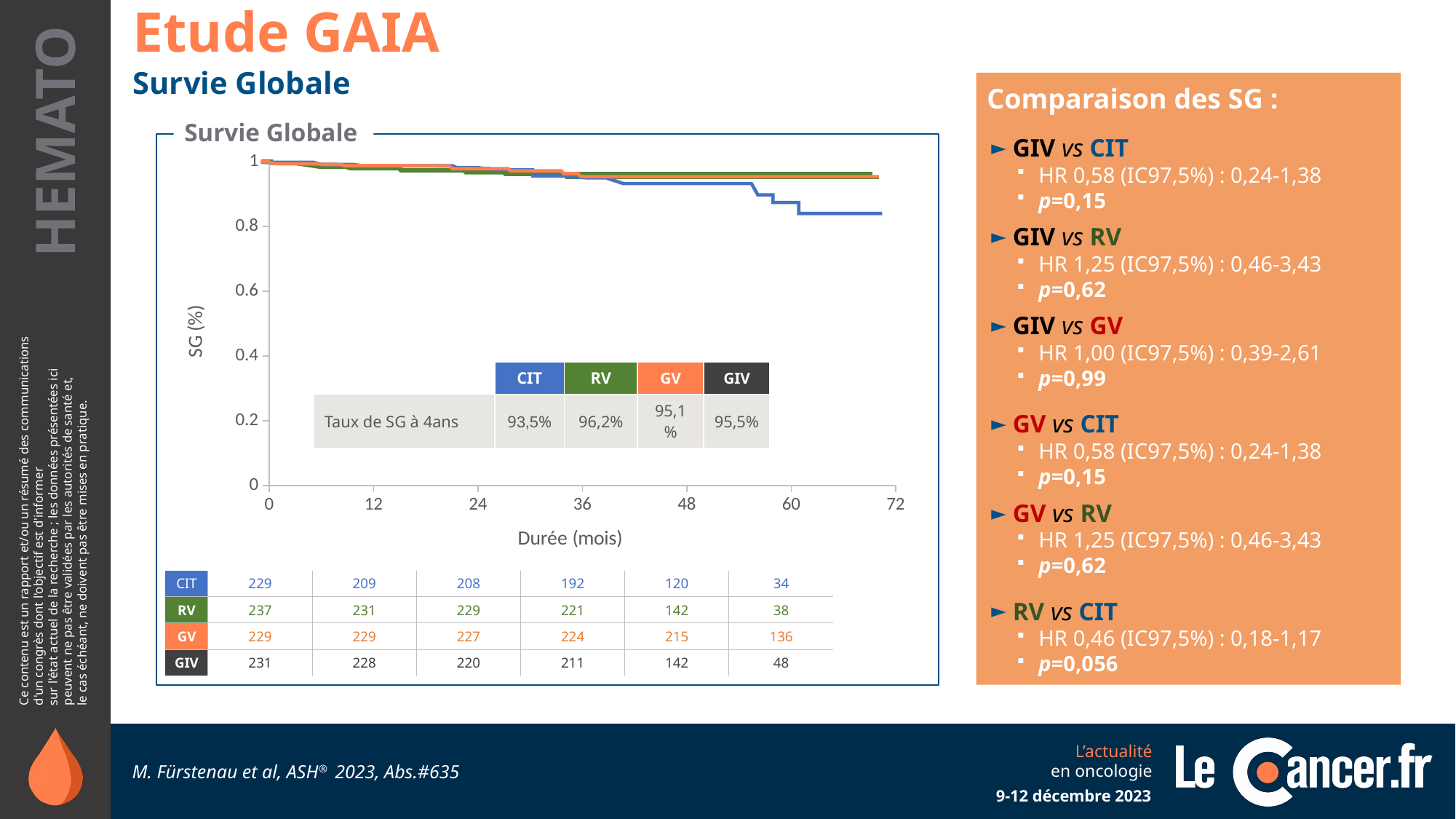
What is the 4-year overall survival rate (Taux de SG à 4ans) for the CIT arm? 93,5% At the end of follow-up (around 70 months), is the CIT survival curve greater or less than 0.8? greater Which arm has the highest 4-year overall survival rate in the inset table? RV What kind of chart is shown under the title "Survie Globale"? line chart Do the survival curves rise or fall as duration (mois) increases? fall How many patients at risk are listed for the GV arm at the first time point (0 months)? 229 Which arm has a higher 4-year survival rate, GV or GIV? GIV What is the 4-year overall survival rate (Taux de SG à 4ans) for the RV arm? 96,2% Which arm has the lowest 4-year overall survival rate in the inset table? CIT What is the difference between the 4-year survival rates of RV and CIT? 2,7% How many treatment arms (series) are plotted on the survival chart? 4 What is the label of the x axis of the survival chart? Durée (mois)